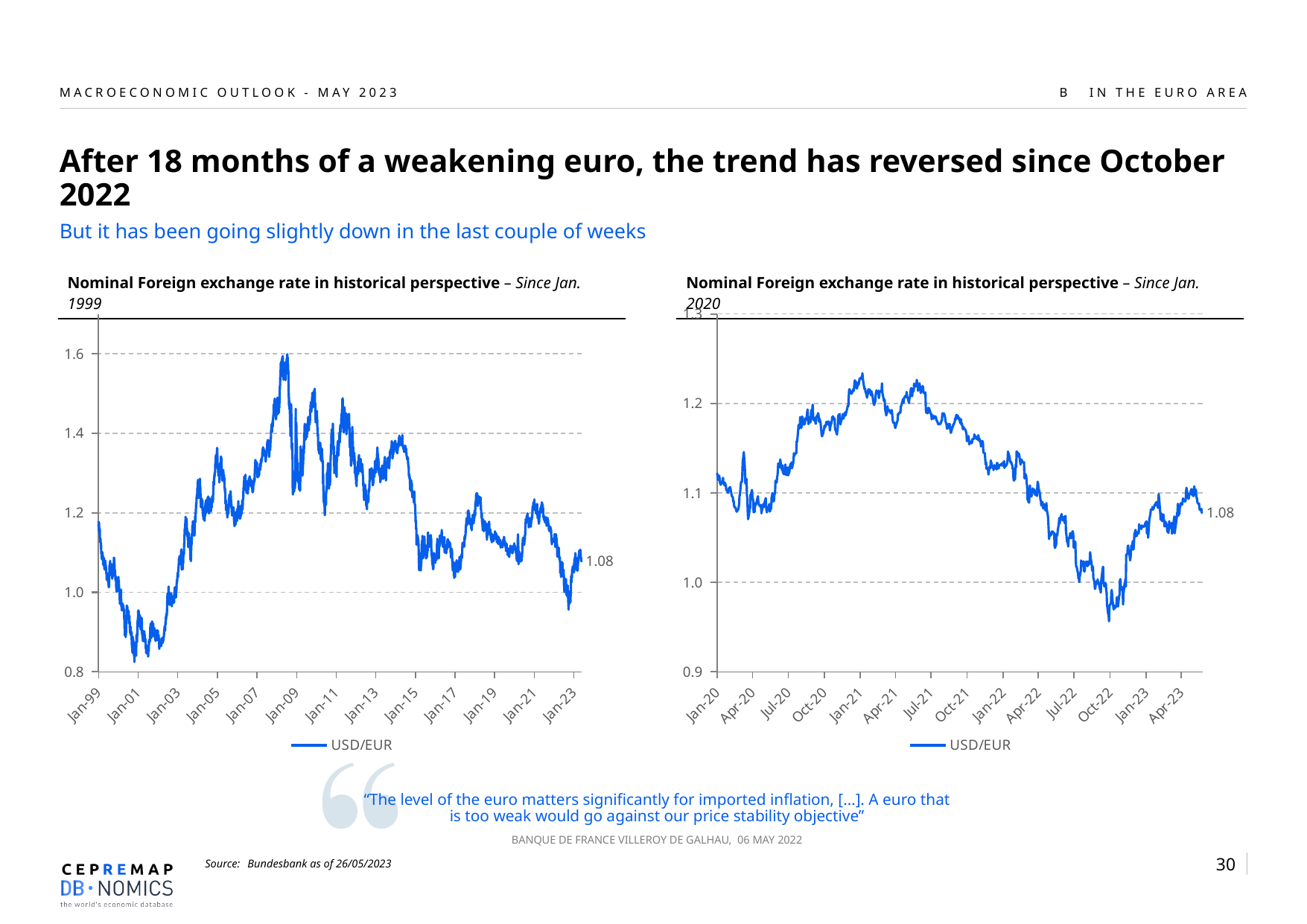
In the right chart (since Jan. 2020), what is the latest value labelled at the end of the USD/EUR line? 1.08 In the left chart (since Jan. 1999), what is the latest value labelled at the end of the USD/EUR line? 1.08 In the right chart (since Jan. 2020), is the USD/EUR value around Jan-21 greater or less than 1.2? greater What is the name of the series shown in the right chart (since Jan. 2020)? USD/EUR In the left chart (since Jan. 1999), is the peak USD/EUR value reached around 2008 greater or less than 1.4? greater What kind of chart is the right chart, 'Nominal Foreign exchange rate in historical perspective – Since Jan. 2020'? Line chart What kind of chart is the left chart, 'Nominal Foreign exchange rate in historical perspective – Since Jan. 1999'? Line chart In the right chart (since Jan. 2020), does the USD/EUR line rise or fall between Oct-22 and Jan-23? Rise In the right chart (since Jan. 2020), does the USD/EUR line rise or fall between Jan-21 and Oct-22? Fall In the right chart (since Jan. 2020), is the USD/EUR value around Oct-22 greater or less than 1.0? less How many series does the legend of the left chart (since Jan. 1999) list? 1